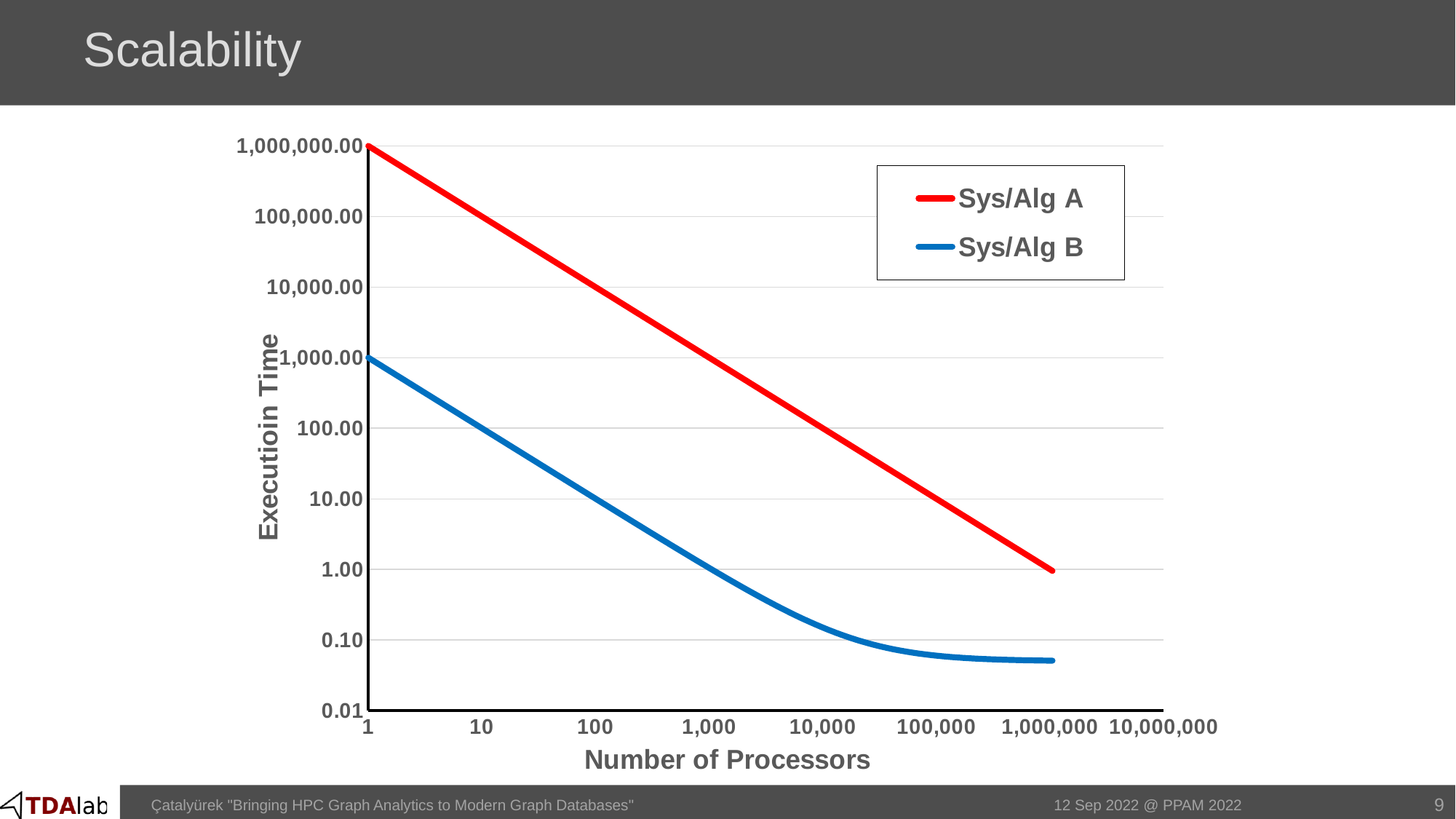
Which colour is used for the Sys/Alg B line? blue How many series does the legend list? 2 What is the label of the x axis? Number of Processors Which series has the higher execution time at 1,000 processors, Sys/Alg A or Sys/Alg B? Sys/Alg A Is the execution time of Sys/Alg B at 1,000,000 processors greater or less than 0.10? less What is the execution time of Sys/Alg A at 1 processor? 1,000,000.00 Does the execution time of Sys/Alg A rise or fall as the number of processors increases? fall What kind of chart is shown on the slide? line chart What is the execution time of Sys/Alg B at 1 processor? 1,000.00